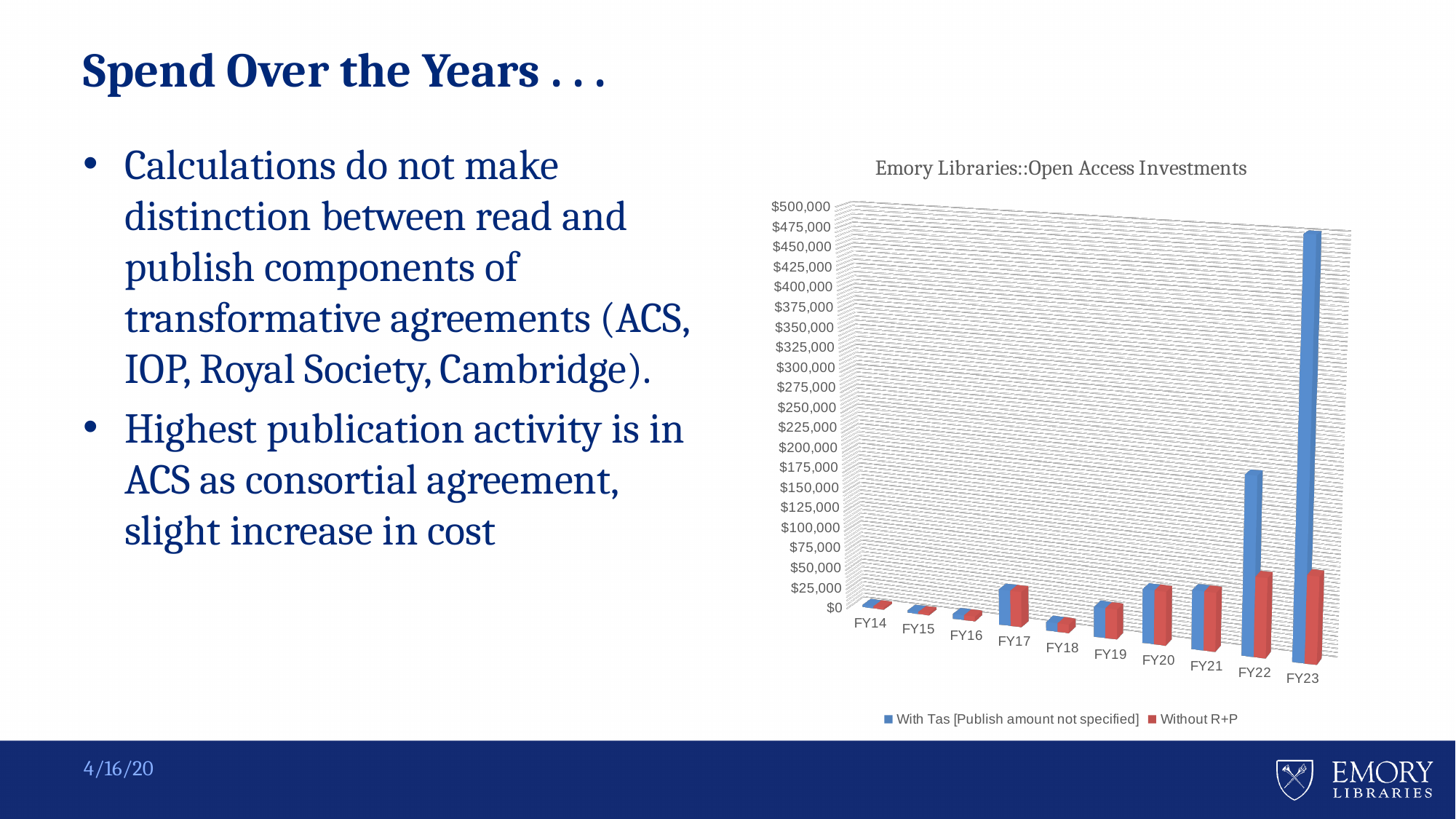
How many fiscal years are shown on the x axis of the chart? 10 What kind of chart is shown on the slide? bar chart Which colour represents the 'Without R+P' series in the chart? red Is the 'With Tas [Publish amount not specified]' value for FY17 greater or less than $100,000? less Which fiscal year has the highest value for the 'With Tas [Publish amount not specified]' series? FY23 Is the 'With Tas [Publish amount not specified]' value for FY22 greater or less than $100,000? greater What is the title of the chart? Emory Libraries::Open Access Investments Which is larger for the 'With Tas [Publish amount not specified]' series: FY22 or FY23? FY23 In FY23, which series has the larger value: 'With Tas [Publish amount not specified]' or 'Without R+P'? With Tas [Publish amount not specified] Is the 'With Tas [Publish amount not specified]' value for FY23 greater or less than $400,000? greater How many series does the chart legend list? 2